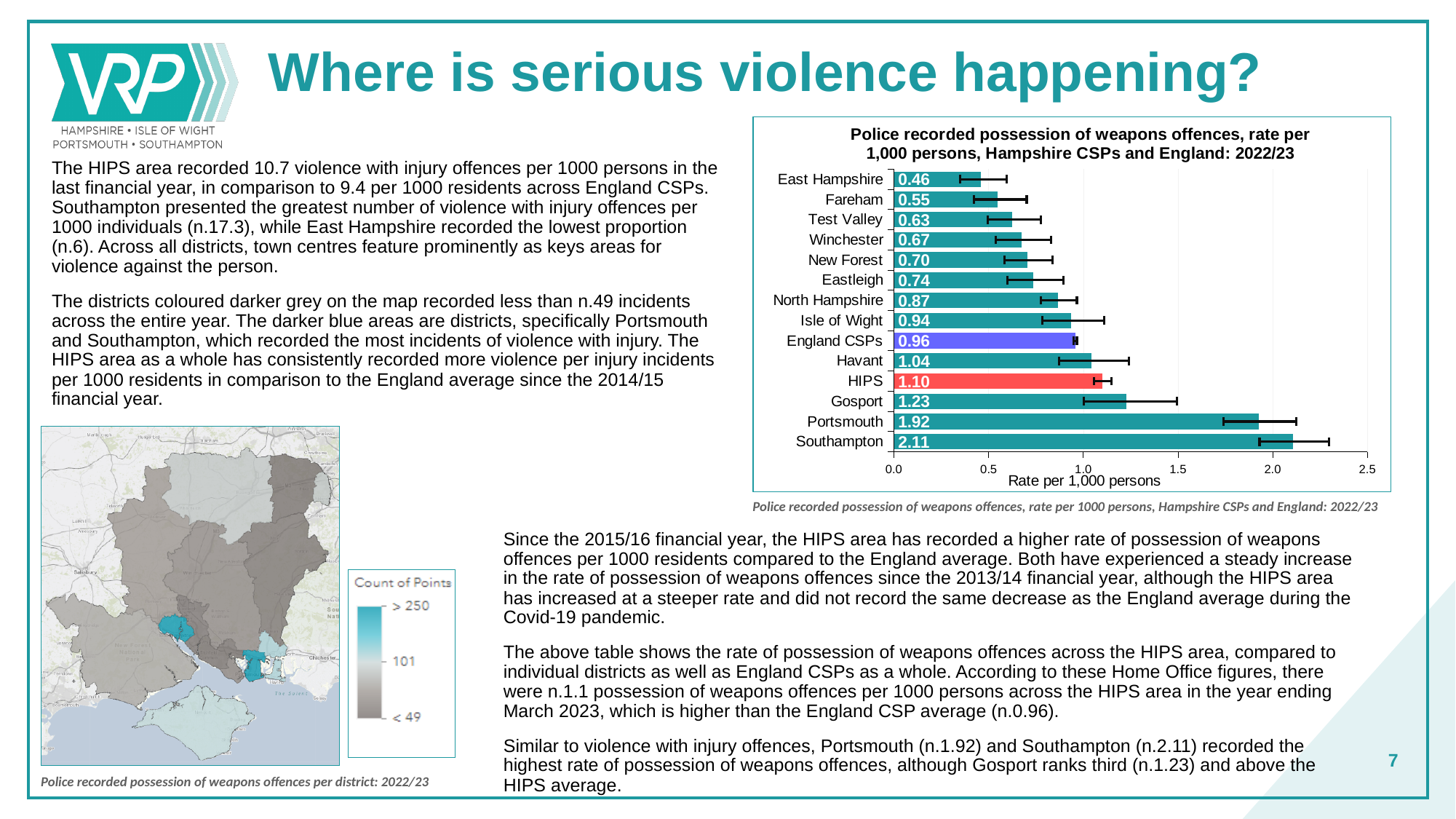
Is the value for Portsmouth in the bar chart greater or less than 1.5? greater Which area has the lowest rate of possession of weapons offences in the bar chart? East Hampshire What is the rate per 1,000 persons for England CSPs in the bar chart? 0.96 What is the rate per 1,000 persons for Southampton in the bar chart? 2.11 How many areas are shown in the bar chart? 14 Which has a higher rate in the bar chart, Havant or Isle of Wight? Havant What is the rate per 1,000 persons for HIPS in the bar chart? 1.10 What is the difference between the rates for Portsmouth and Gosport in the bar chart? 0.69 What is the x-axis label of the bar chart? Rate per 1,000 persons Which bar in the chart is coloured red? HIPS What kind of chart is used to show the possession of weapons offences rates? Bar chart Which area has the highest rate of possession of weapons offences in the bar chart? Southampton